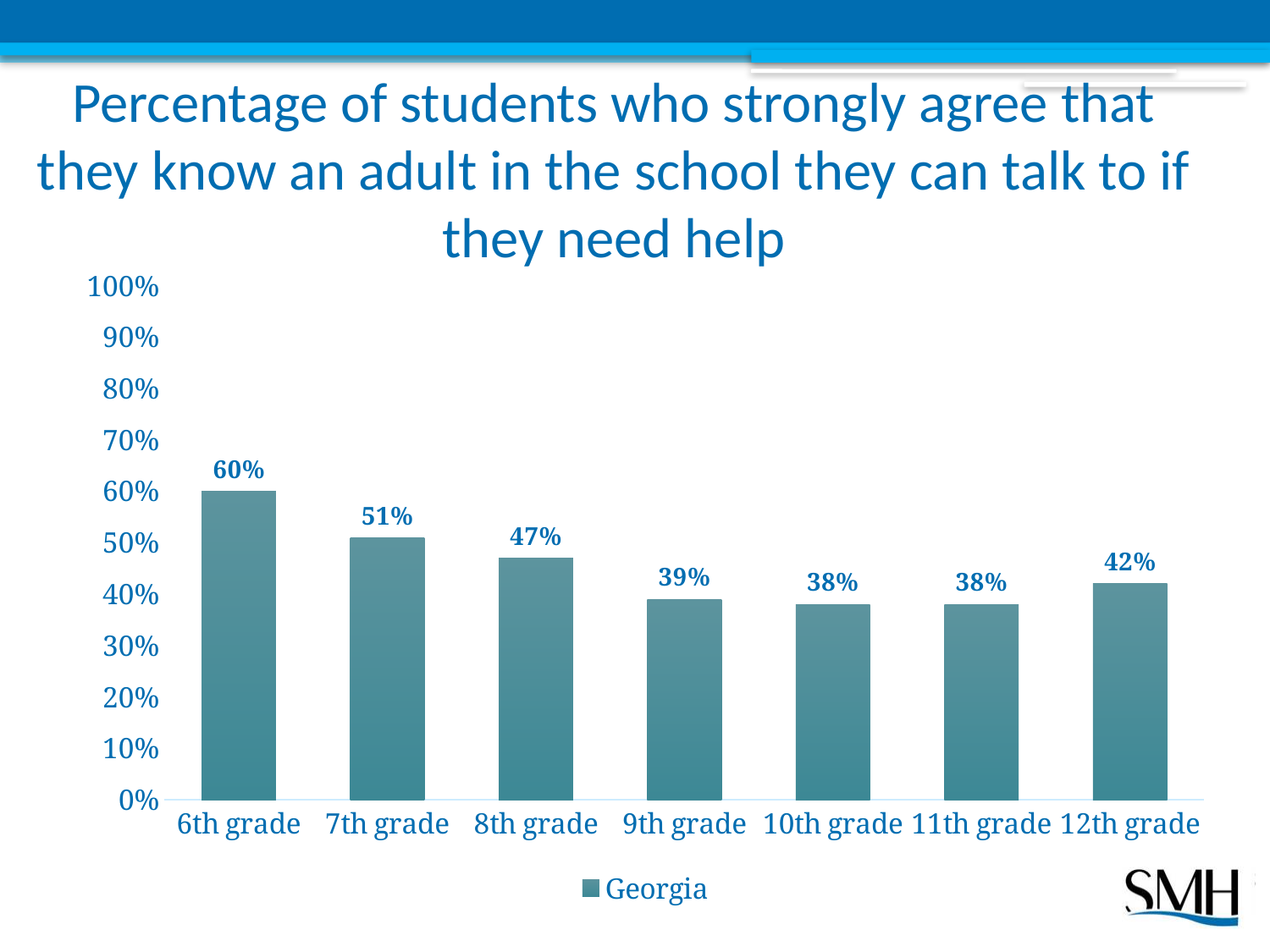
What is the name of the series shown in the legend? Georgia How many series does the legend list? 1 What is the value shown for 9th grade? 39% Which grade has the highest percentage of students who strongly agree? 6th grade What percentage of 6th grade students strongly agree that they know an adult in the school they can talk to? 60% What is the value shown for 12th grade? 42% What is the difference between the values for 8th grade and 12th grade? 5% What kind of chart is shown on the slide? bar chart What is the difference between the values for 6th grade and 7th grade? 9% How many grade categories are shown on the x axis? 7 Is the value for 7th grade greater or less than 50%? greater Which is larger, the value for 9th grade or the value for 12th grade? 12th grade